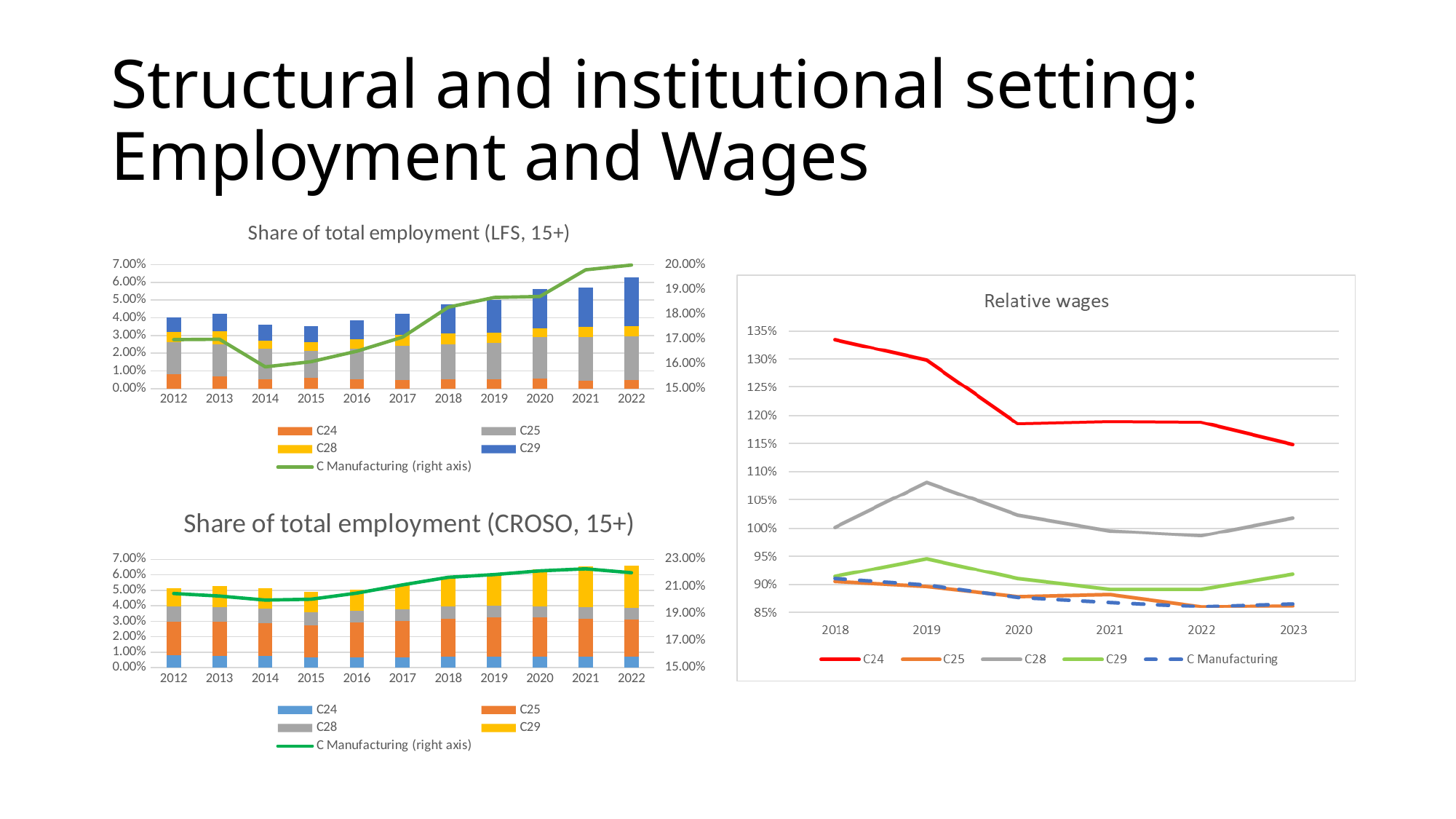
How many years are shown on the x axis of the 'Share of total employment (LFS, 15+)' chart? 11 In the 'Relative wages' chart, which is larger in 2020, C24 or C28? C24 In the 'Relative wages' chart, does the C24 line rise or fall from 2018 to 2023? fall In the 'Share of total employment (LFS, 15+)' chart, is the C Manufacturing (right axis) value for 2014 greater or less than 17.00%? less In the 'Relative wages' chart, in which year does the C28 line reach its highest value? 2019 How many series does the legend of the 'Relative wages' chart list? 5 What kind of chart is the 'Relative wages' chart? line chart In the 'Share of total employment (LFS, 15+)' chart, which year has the tallest stacked bar? 2022 In the 'Share of total employment (CROSO, 15+)' chart, which series is plotted as a line on the right axis? C Manufacturing (right axis) How many years are shown on the x axis of the 'Relative wages' chart? 6 In the 'Relative wages' chart, which series has the highest value in 2018? C24 In the 'Relative wages' chart, is the value for C24 in 2018 greater or less than 130%? greater